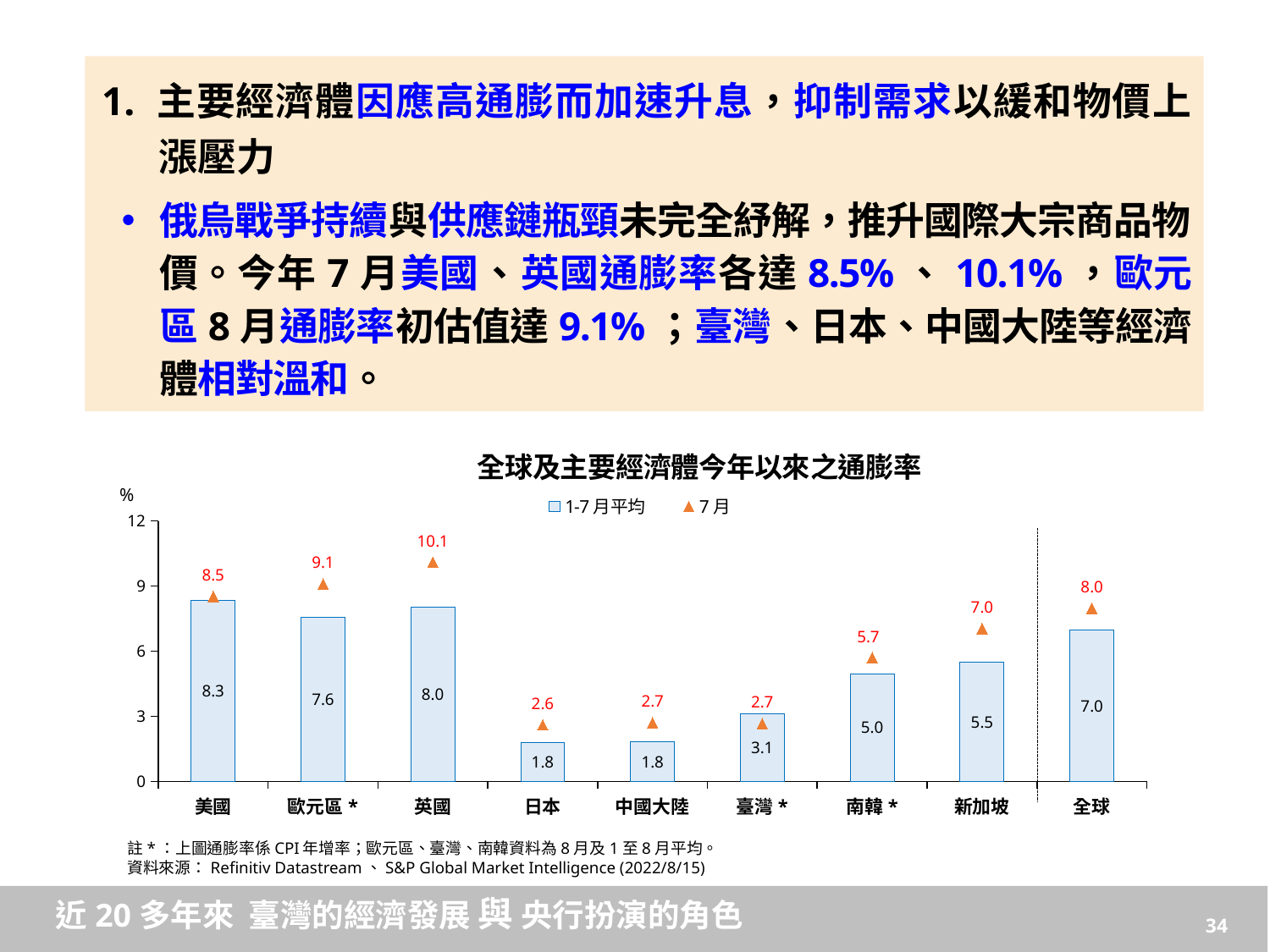
What is the difference between the 7月 value and the 1-7月平均 value for 歐元區 *? 1.5 Which category has the lowest 7月 value? 日本 How many categories are shown on the x axis? 9 Which category has the highest 1-7月平均 value? 美國 What is the 7月 inflation rate for 英國? 10.1 What is the title of the chart? 全球及主要經濟體今年以來之通膨率 What is the 1-7月平均 value for 新加坡? 5.5 Which is larger, the 1-7月平均 value for 南韓 * or for 臺灣 *? 南韓 * How many series does the legend list? 2 Which category has the highest 7月 value? 英國 What is the 1-7月平均 inflation rate for 美國? 8.3 What kind of chart is this? bar chart